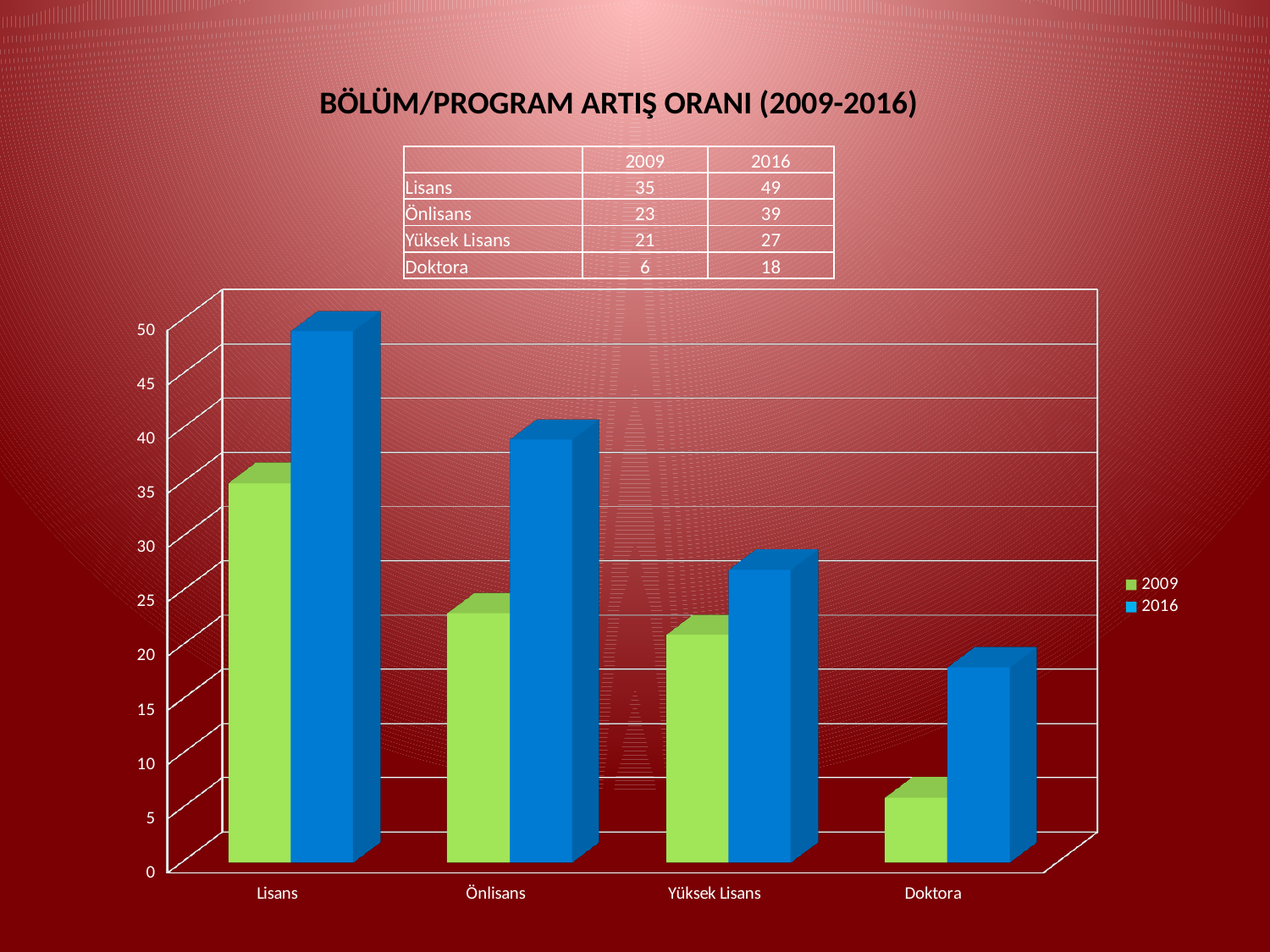
Is the 2016 value for Doktora greater or less than 20? less What is the value for Lisans in 2016? 49 How many categories are shown on the x axis of the chart? 4 Which category has the highest value in the 2016 series? Lisans What is the difference between the 2016 and 2009 values for Önlisans? 16 What is the title of the chart? BÖLÜM/PROGRAM ARTIŞ ORANI (2009-2016) Which category has the lowest value in the 2009 series? Doktora What is the value for Doktora in 2009? 6 Which is larger, the 2009 value for Lisans or the 2016 value for Yüksek Lisans? 2009 value for Lisans What type of chart is shown on the slide? bar chart What is the value for Önlisans in 2016? 39 How many series does the chart legend list? 2